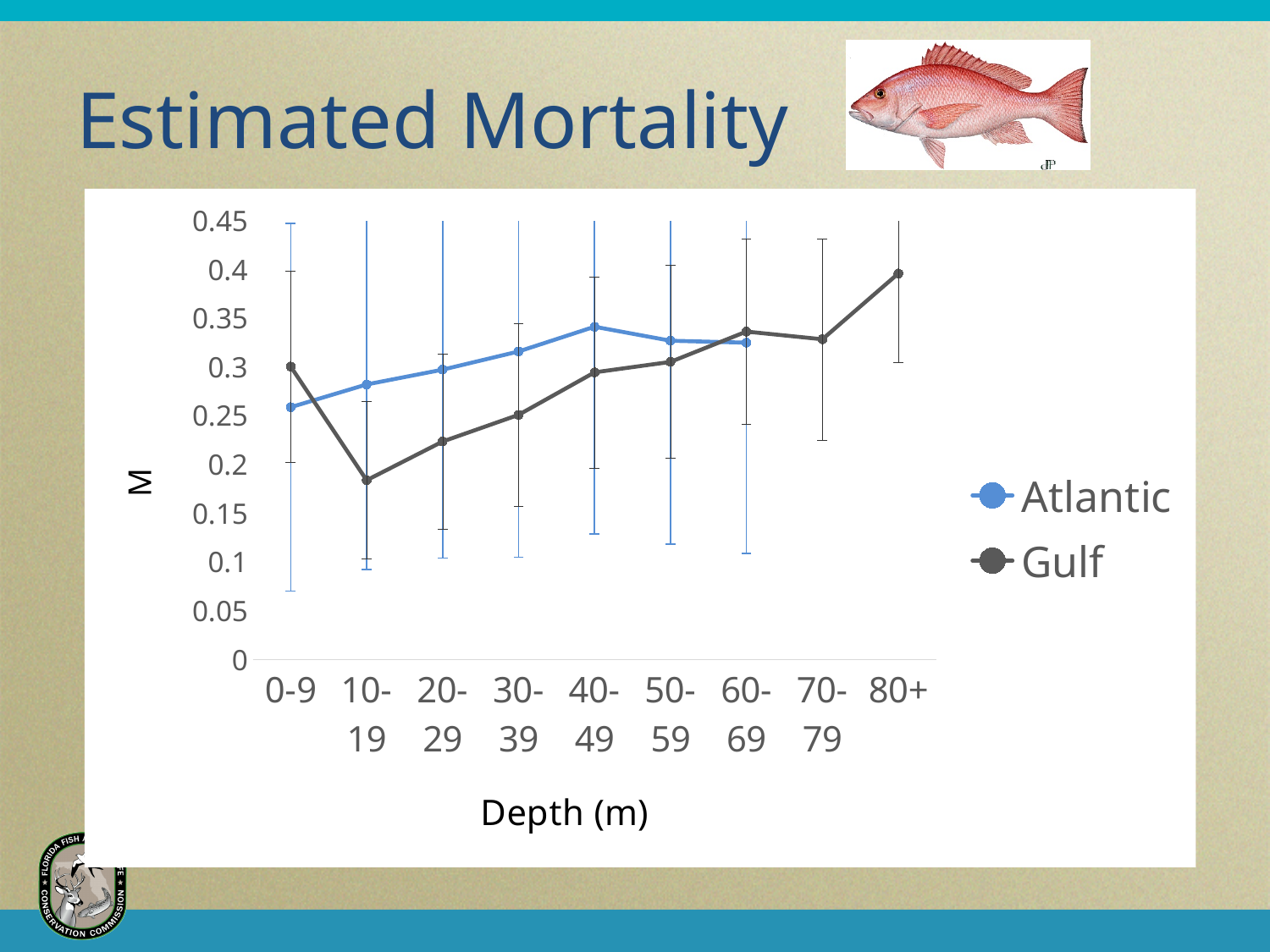
How many depth categories are shown on the x axis? 9 At the 10-19 depth category, which series has the larger value, Atlantic or Gulf? Atlantic Is the Atlantic value for the 40-49 depth category greater or less than 0.3? greater Which depth category has the highest value for the Gulf series? 80+ Is the Gulf value for the 80+ depth category greater or less than 0.35? greater Does the Gulf series rise or fall from the 10-19 depth category to the 80+ depth category? Rise How many series does the legend list? 2 What kind of chart is shown on the slide? Line chart Which depth category has the lowest value for the Gulf series? 10-19 Is the Gulf value for the 10-19 depth category greater or less than 0.2? less At the 0-9 depth category, which series has the larger value, Atlantic or Gulf? Gulf What is the label of the x axis? Depth (m)